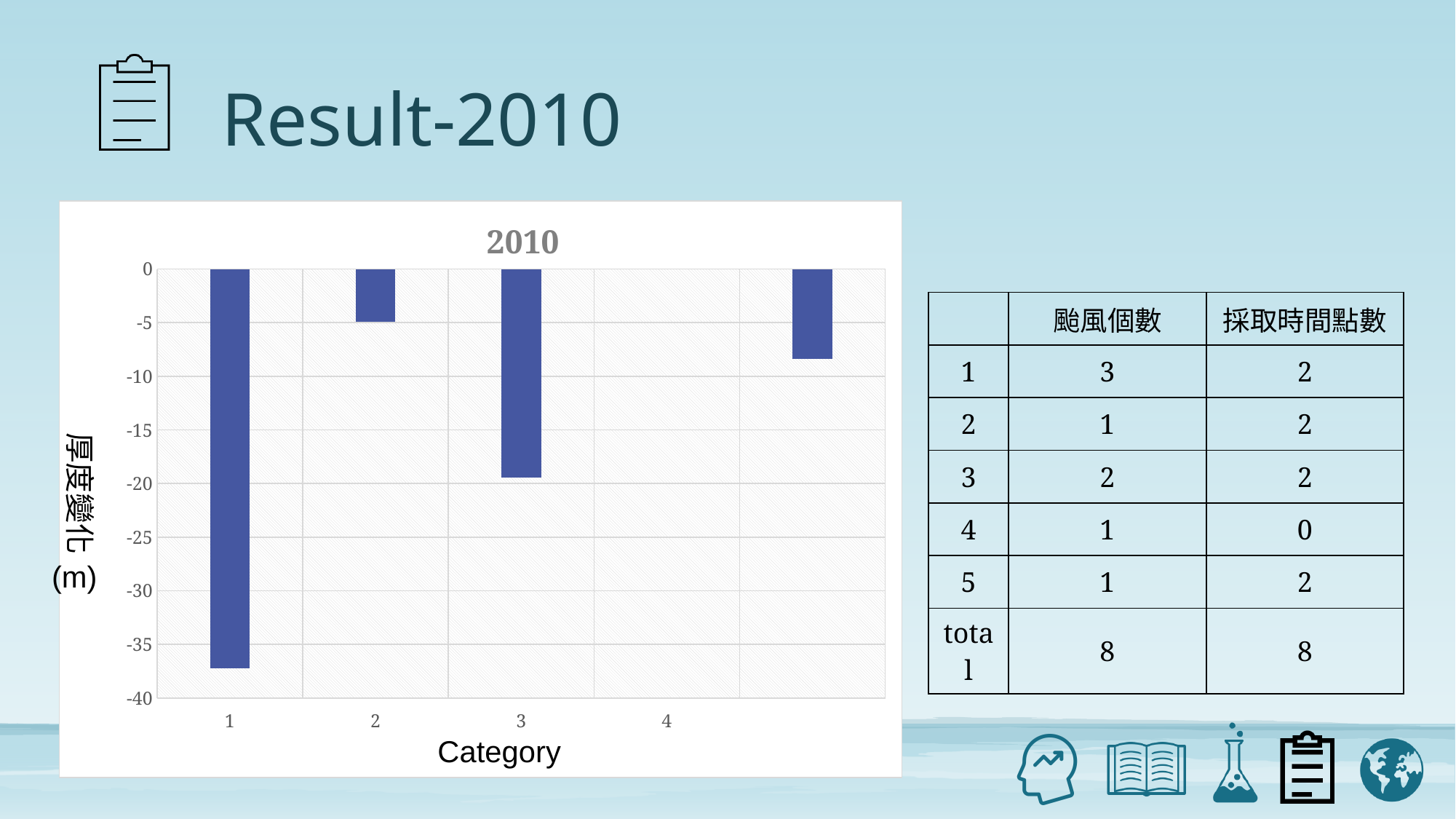
Which has the larger value, category 2 or category 3? 2 Is the value for category 2 greater or less than -10? greater Is the value for category 1 greater or less than -35? less Is the value for category 3 greater or less than -25? greater How many category labels are shown on the x axis of the chart? 4 What is the label on the vertical axis of the chart? 厚度變化 (m) Which category has the lowest (most negative) value in the chart? 1 Which has the lower value, category 1 or category 3? 1 What kind of chart is shown on the slide? bar chart What is the title of the chart? 2010